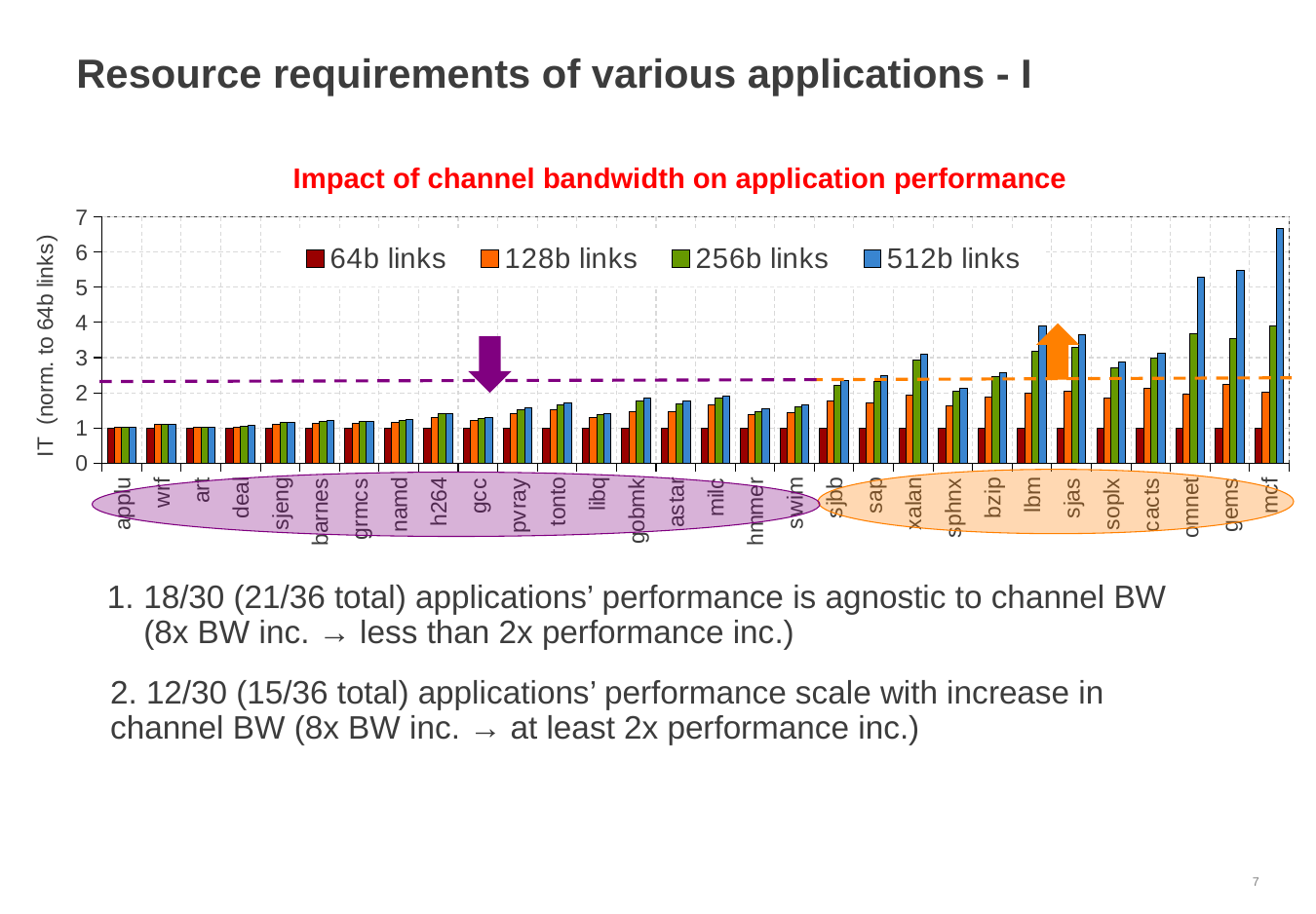
Is the 512b links value for lbm greater or less than 3? greater Do the 512b links values generally rise or fall moving from left to right along the x axis? rise Is the 512b links value for mcf greater or less than 6? greater Which application has the highest value for 512b links? mcf How many applications (categories) are plotted along the x axis? 30 What kind of chart is shown on the slide? bar chart Is the 512b links value for applu greater or less than 2? less What is the label on the y axis? IT (norm. to 64b links) Which has the larger 512b links value, gems or sjbb? gems How many series does the legend list? 4 What is the title of the chart? Impact of channel bandwidth on application performance